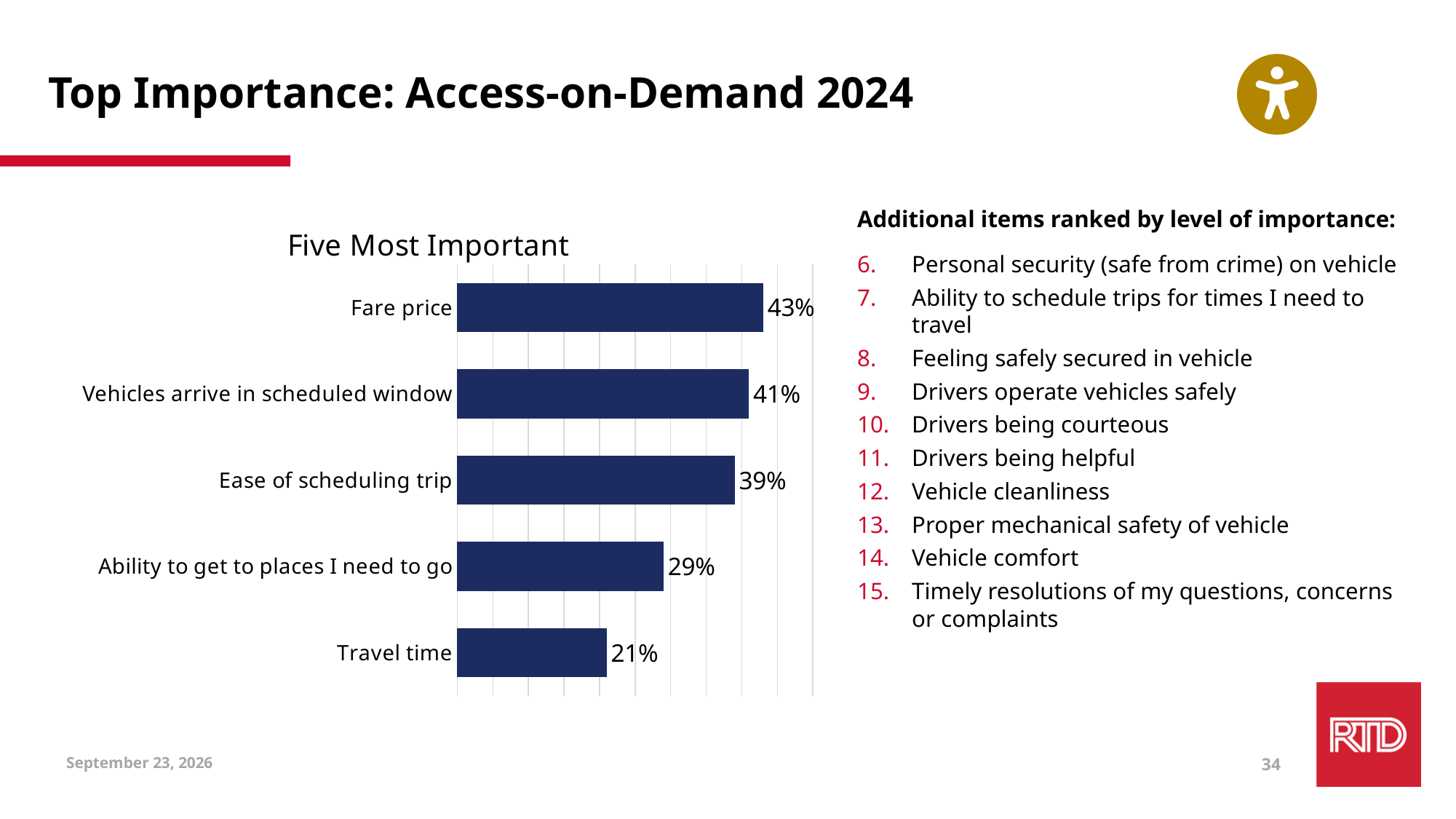
Which category has the highest value? Fare price What is the value for Fare price? 43% What is the value for Travel time? 21% What is the value for Vehicles arrive in scheduled window? 41% Which category has the lowest value? Travel time Which is larger, the value for Ability to get to places I need to go or the value for Travel time? Ability to get to places I need to go What is the title of the chart? Five Most Important How many categories are shown in the chart? 5 What is the value for Ease of scheduling trip? 39% What kind of chart is shown on the slide? Bar chart What is the difference between the values for Ease of scheduling trip and Ability to get to places I need to go? 10% What is the difference between the values for Fare price and Travel time? 22%